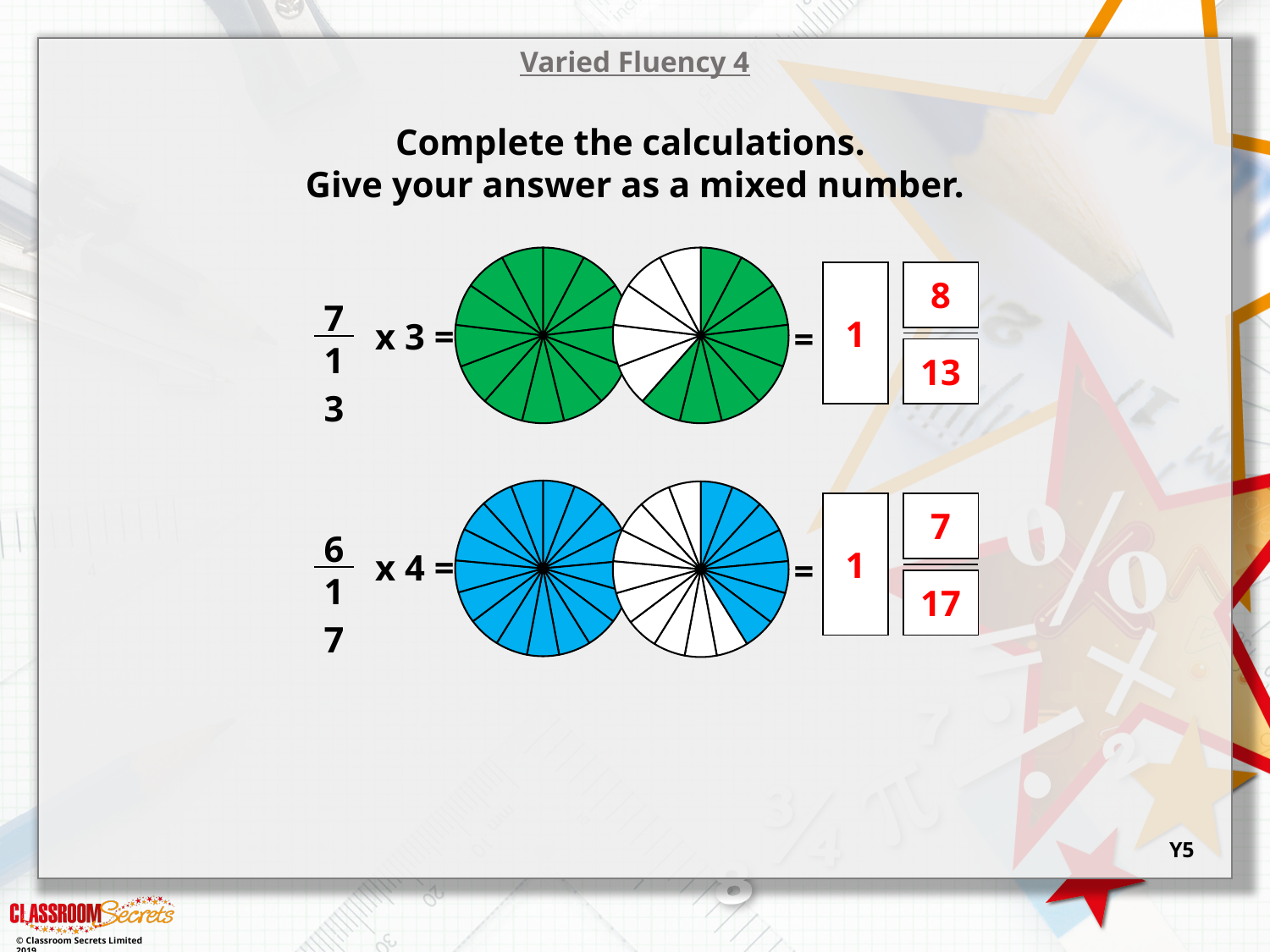
What colour are the shaded sections in the top row of circles? green In the bottom row, what fraction of the second (partly shaded) circle is shaded? 7/17 What kind of diagrams are used to model the fractions on the slide? pie charts In the top row, what fraction of the second (partly shaded) circle is shaded? 8/13 Into how many equal sections is each circle in the bottom row divided? 17 How many circle diagrams are shown on the slide in total? 4 What is the mixed number answer shown for the bottom calculation, 6/17 x 4? 1 7/17 What colour are the shaded sections in the bottom row of circles? blue What is the mixed number answer shown for the top calculation, 7/13 x 3? 1 8/13 Into how many equal sections is each circle in the top row divided? 13